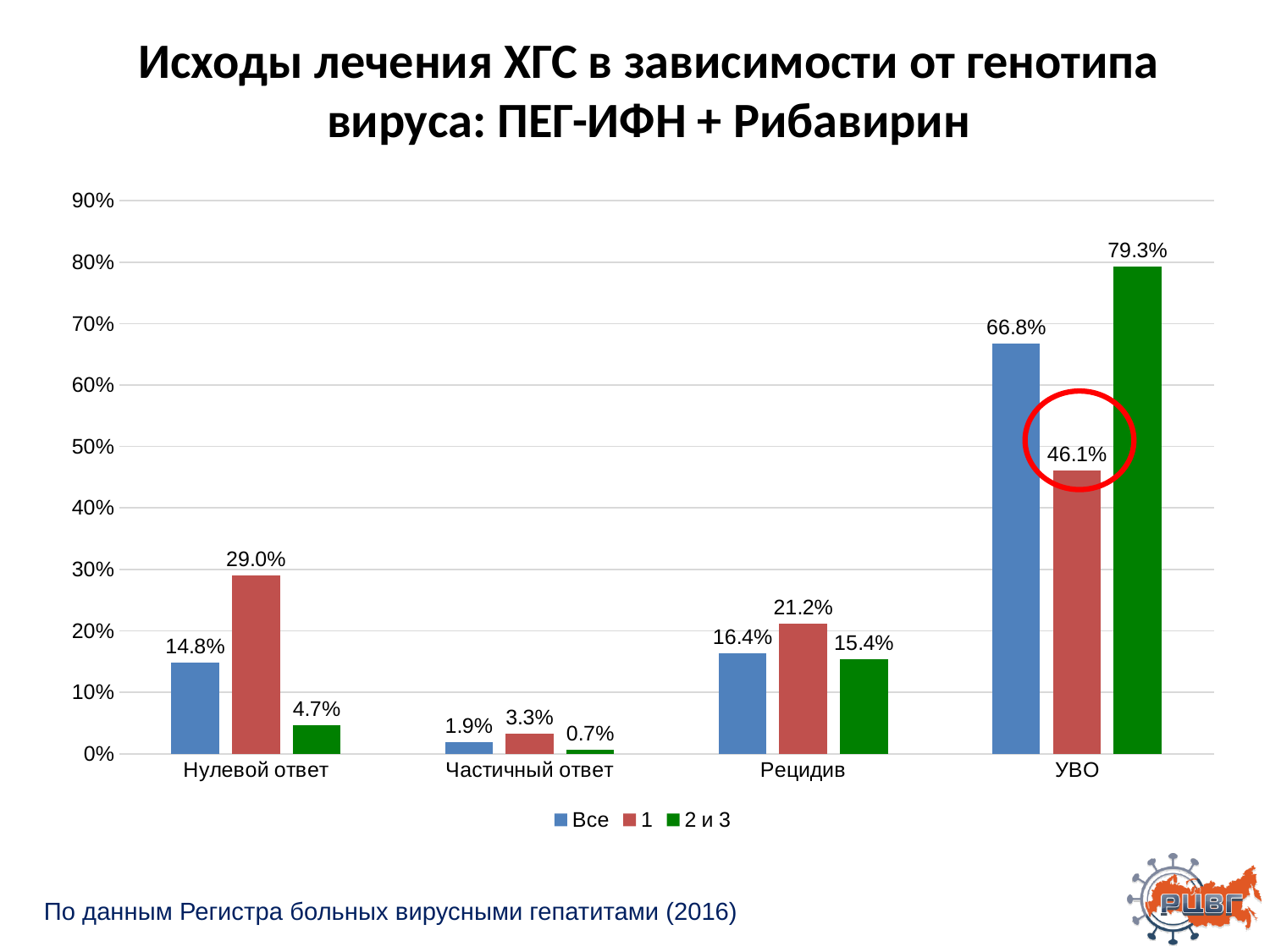
What is the difference between the "2 и 3" and "1" values in the "УВО" category? 33.2% What is the value for the "1" series in the "УВО" category? 46.1% What is the value for the "2 и 3" series in the "Нулевой ответ" category? 4.7% What is the value for the "Все" series in the "Рецидив" category? 16.4% Is the value for the "Все" series in the "УВО" category greater or less than 60%? greater Which category has the highest value for the "2 и 3" series? УВО In the "Нулевой ответ" category, which series has the larger value: "Все" or "1"? 1 What kind of chart is shown on the slide? Bar chart How many series does the legend list? 3 Which bar is highlighted with a red circle? The "1" series bar in the "УВО" category (46.1%) How many categories are shown on the x axis? 4 Which category has the lowest value for the "Все" series? Частичный ответ